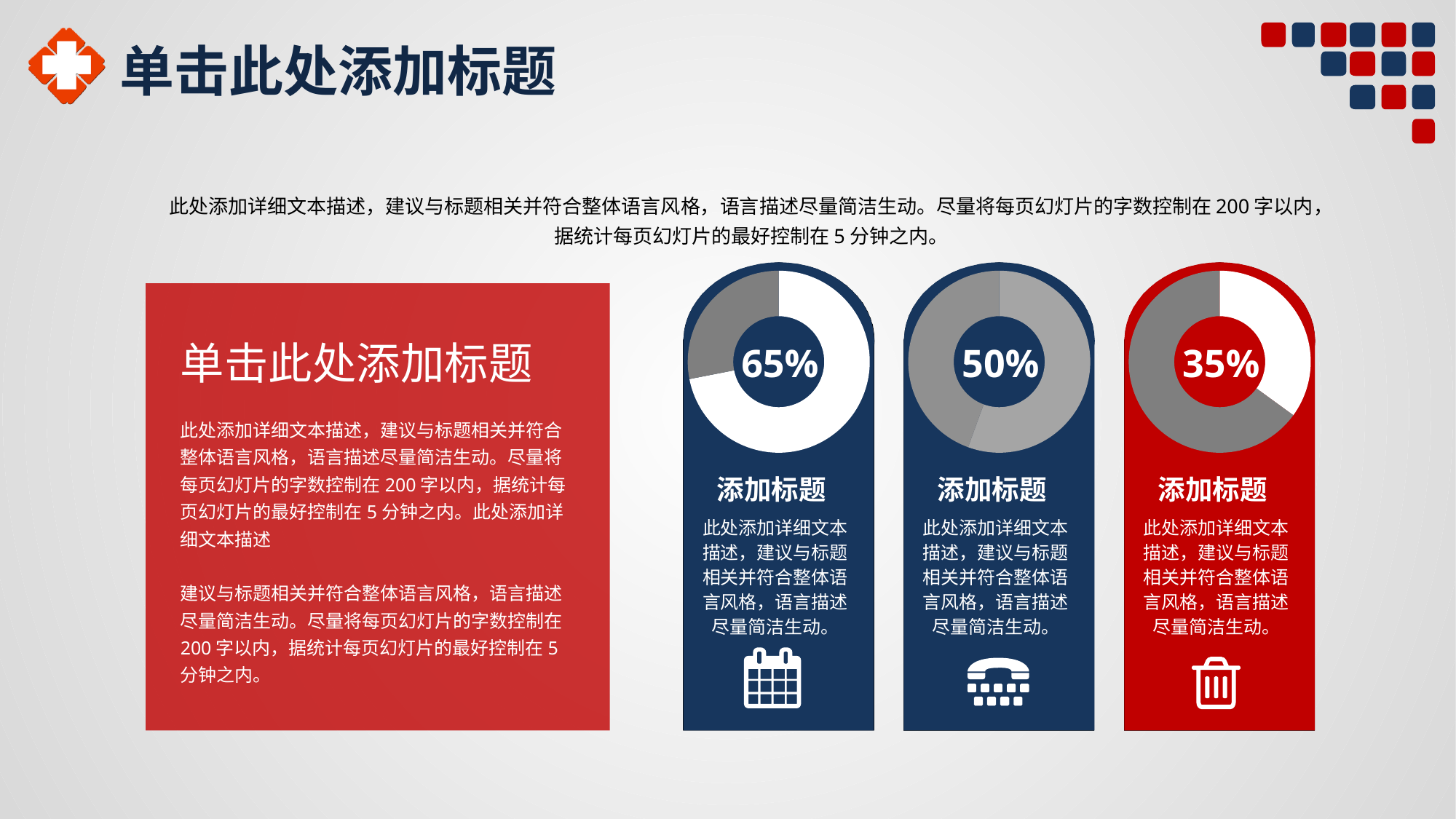
What percentage is shown in the centre of the left donut chart? 65% What percentage is shown in the centre of the right donut chart? 35% Which of the three donut charts shows the lowest percentage: left, middle or right? right What is the difference between the percentage in the left donut chart and the percentage in the right donut chart? 30% What colour is the background of the column containing the 35% donut chart? red Which of the three donut charts shows the highest percentage: left, middle or right? left Which is larger, the percentage in the middle donut chart or the percentage in the right donut chart? middle donut chart What is the difference between the percentage in the left donut chart and the percentage in the middle donut chart? 15% How many donut charts are on the slide? 3 What percentage is shown in the centre of the middle donut chart? 50% Do the percentages in the donut charts increase or decrease from left to right across the slide? decrease What kind of chart is used in each of the three columns on the right side of the slide? donut chart